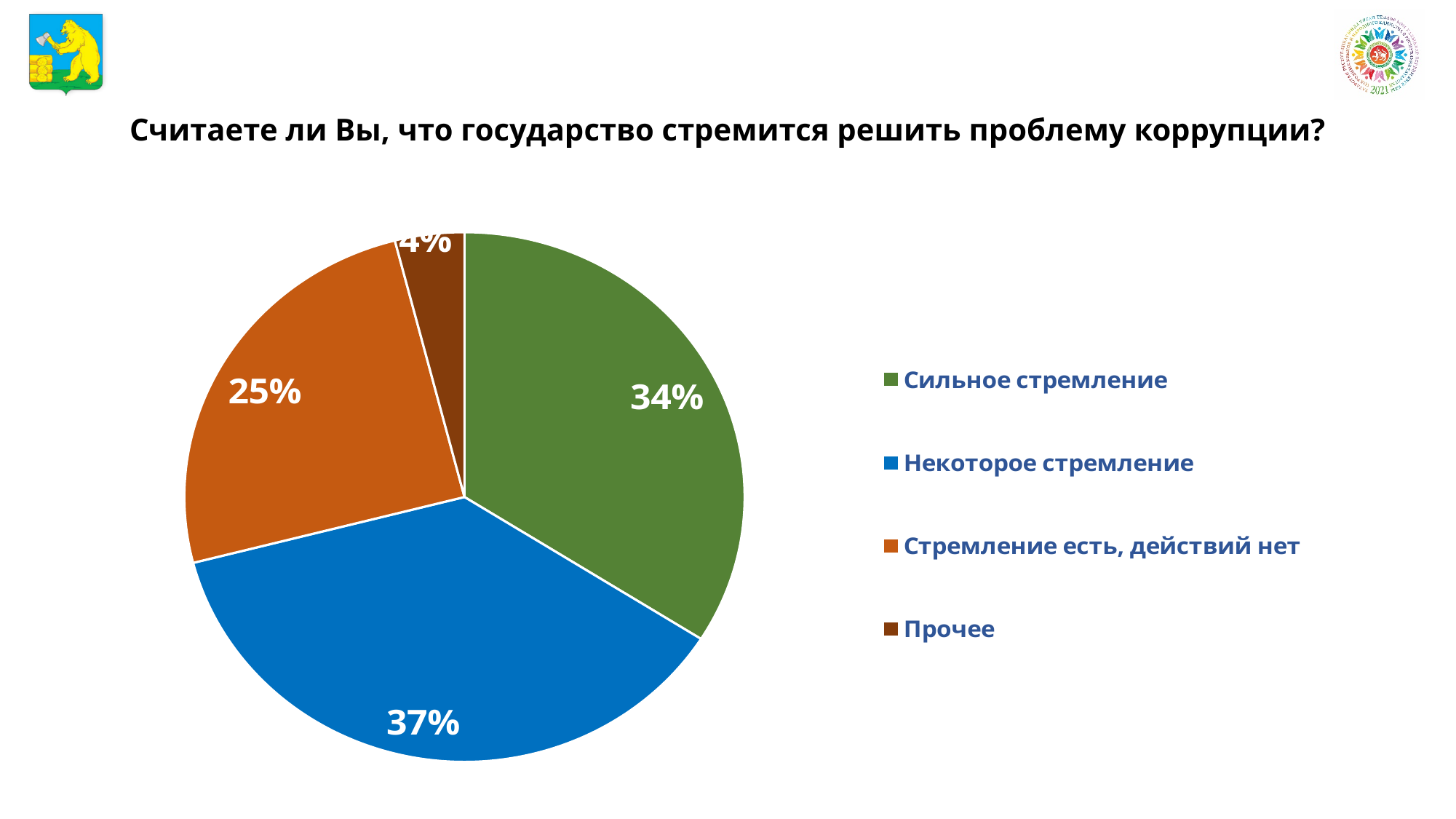
What share of the pie does "Некоторое стремление" have? 37% Which is larger: the share of "Стремление есть, действий нет" or the share of "Прочее"? Стремление есть, действий нет How many categories does the pie chart have? 4 What is the difference between the shares of "Сильное стремление" and "Стремление есть, действий нет"? 9% What colour is the slice for "Прочее"? dark brown What share of the pie does "Прочее" have? 4% What share of the pie does "Сильное стремление" have? 34% What is the difference between the shares of "Некоторое стремление" and "Сильное стремление"? 3% Which category has the smallest slice of the pie? Прочее Which category has the largest slice of the pie? Некоторое стремление What share of the pie does "Стремление есть, действий нет" have? 25% What type of chart is shown on the slide? pie chart